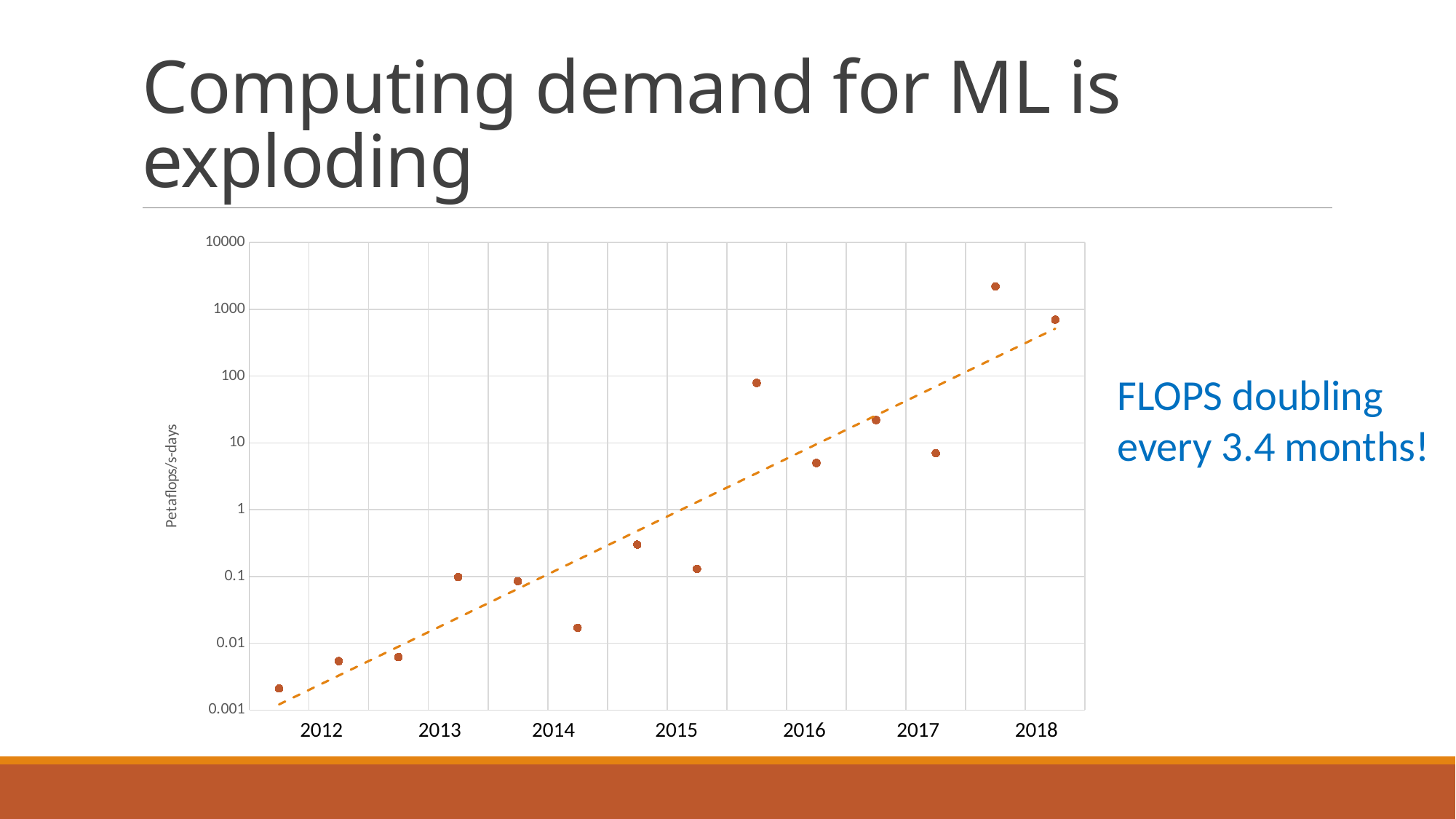
Do the plotted values generally rise or fall from 2012 to 2018? Rise Which is larger: the point plotted just after 2013 or the point plotted just after 2012? The point just after 2013 What is the label on the vertical axis of the chart? Petaflops/s-days Is the lowest plotted point greater or less than 0.01 petaflops/s-days? less Is the point plotted just after 2014 greater or less than 0.1 petaflops/s-days? less What is the first year labelled on the horizontal axis? 2012 Is the highest plotted point greater or less than 1000 petaflops/s-days? greater What is the highest value shown on the vertical axis? 10000 What kind of chart is shown on the slide? Scatter chart How many data points are plotted on the chart? 14 Which is larger: the point plotted just before 2018 or the point plotted just after 2018? The point just before 2018